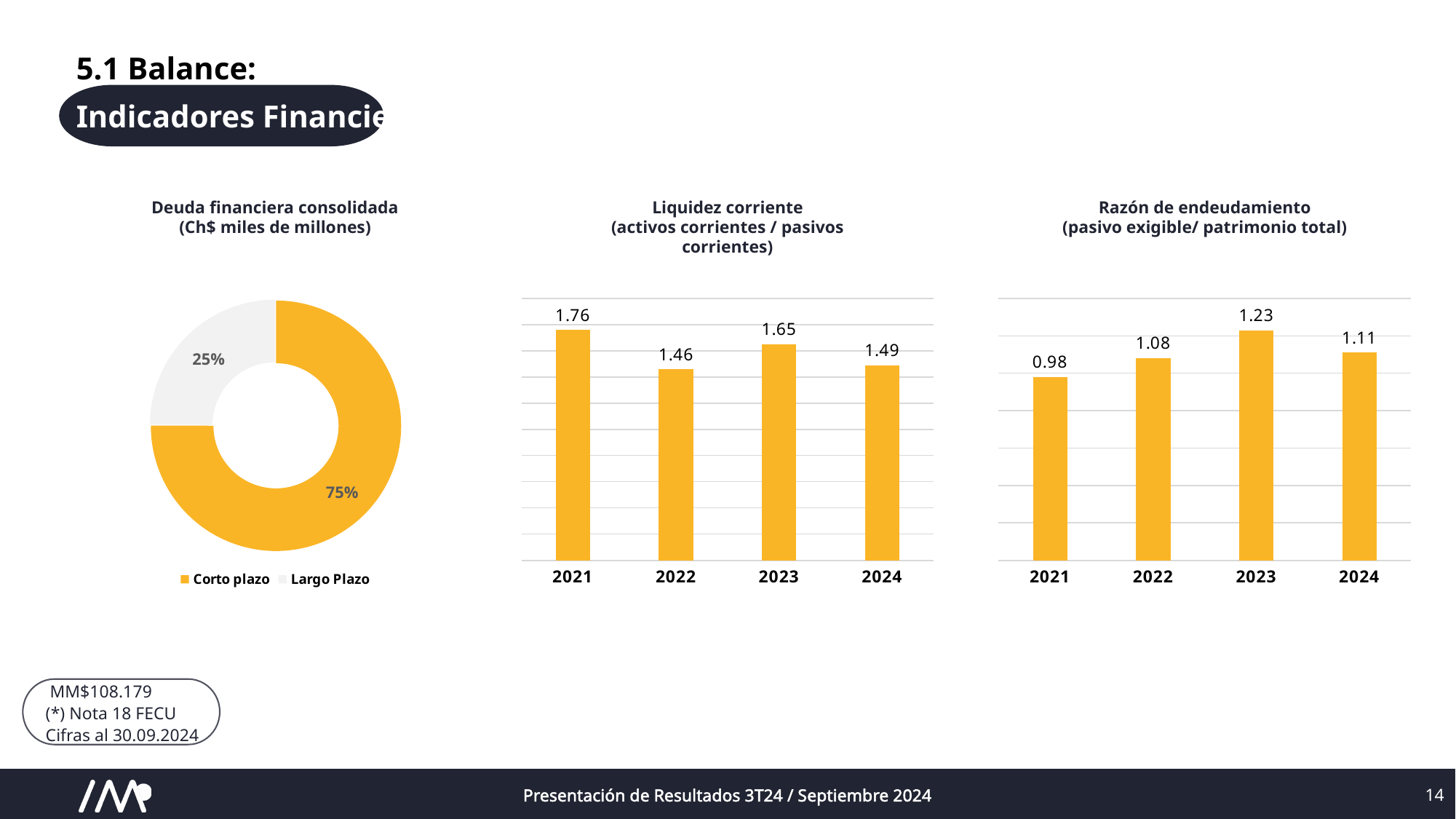
In the 'Liquidez corriente' chart, which year has the lowest value? 2022 In the 'Deuda financiera consolidada' chart, what share does 'Corto plazo' represent? 75% In the 'Deuda financiera consolidada' chart, what share does 'Largo Plazo' represent? 25% In the 'Liquidez corriente' chart, what is the value for 2021? 1.76 How many entries does the legend of the 'Deuda financiera consolidada' chart list? 2 In the 'Razón de endeudamiento' chart, which year has the lowest value? 2021 In the 'Razón de endeudamiento' chart, is the value for 2022 larger or smaller than the value for 2024? Smaller What kind of chart is the 'Deuda financiera consolidada' chart? Pie (doughnut) chart How many years are shown in the 'Liquidez corriente' chart? 4 In the 'Razón de endeudamiento' chart, what is the value for 2023? 1.23 In the 'Liquidez corriente' chart, what is the difference between the 2021 and 2024 values? 0.27 What kind of chart is the 'Razón de endeudamiento' chart? Bar chart